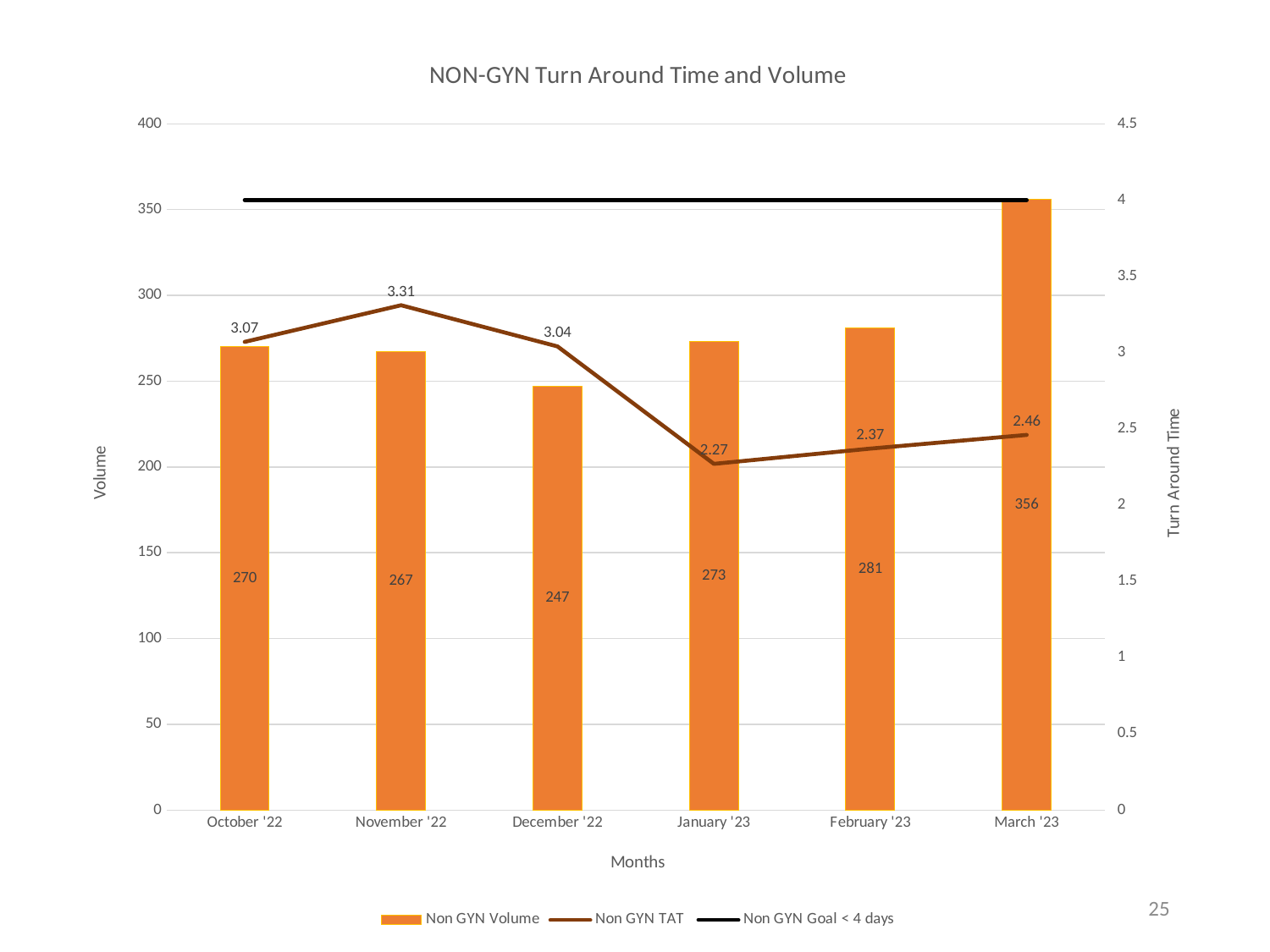
What is the Non GYN Volume for March '23? 356 Which month has the lowest Non GYN TAT? January '23 What is the Non GYN Volume for December '22? 247 What is the difference in Non GYN Volume between March '23 and February '23? 75 Which is larger, the Non GYN TAT for October '22 or for December '22? October '22 What is the title of the chart? NON-GYN Turn Around Time and Volume Which month has the highest Non GYN Volume? March '23 How many series does the legend list? 3 What is the Non GYN TAT for November '22? 3.31 How many months are shown on the x axis? 6 Does the Non GYN TAT rise or fall from November '22 to January '23? fall Is the Non GYN Volume for December '22 greater or less than 250? less